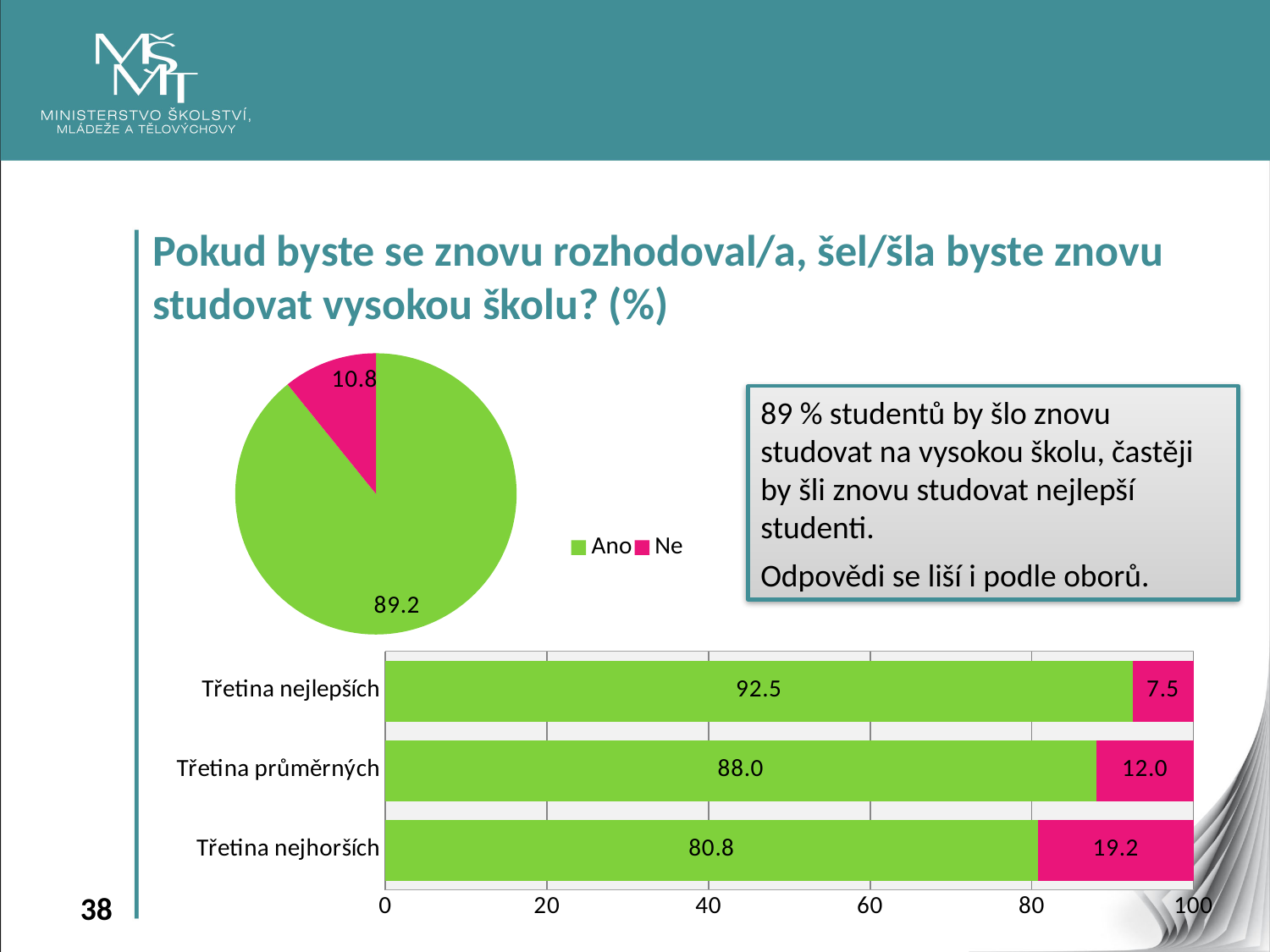
In the bar chart, what is the "Ne" value for "Třetina nejhorších"? 19.2 What kind of chart is the lower chart on the slide? bar chart In the bar chart, which category has the lowest "Ano" value? Třetina nejhorších In the pie chart, what share of respondents answered "Ano"? 89.2 How many categories are shown in the bar chart? 3 What kind of chart is the upper chart on the slide? pie chart In the bar chart, which category has the highest "Ne" value? Třetina nejhorších In the bar chart, what is the "Ano" value for "Třetina průměrných"? 88.0 In the pie chart, what share of respondents answered "Ne"? 10.8 In the bar chart, what is the "Ano" value for "Třetina nejlepších"? 92.5 In the bar chart, what is the difference between the "Ano" values for "Třetina nejlepších" and "Třetina nejhorších"? 11.7 In the pie chart, which slice is larger, "Ano" or "Ne"? Ano